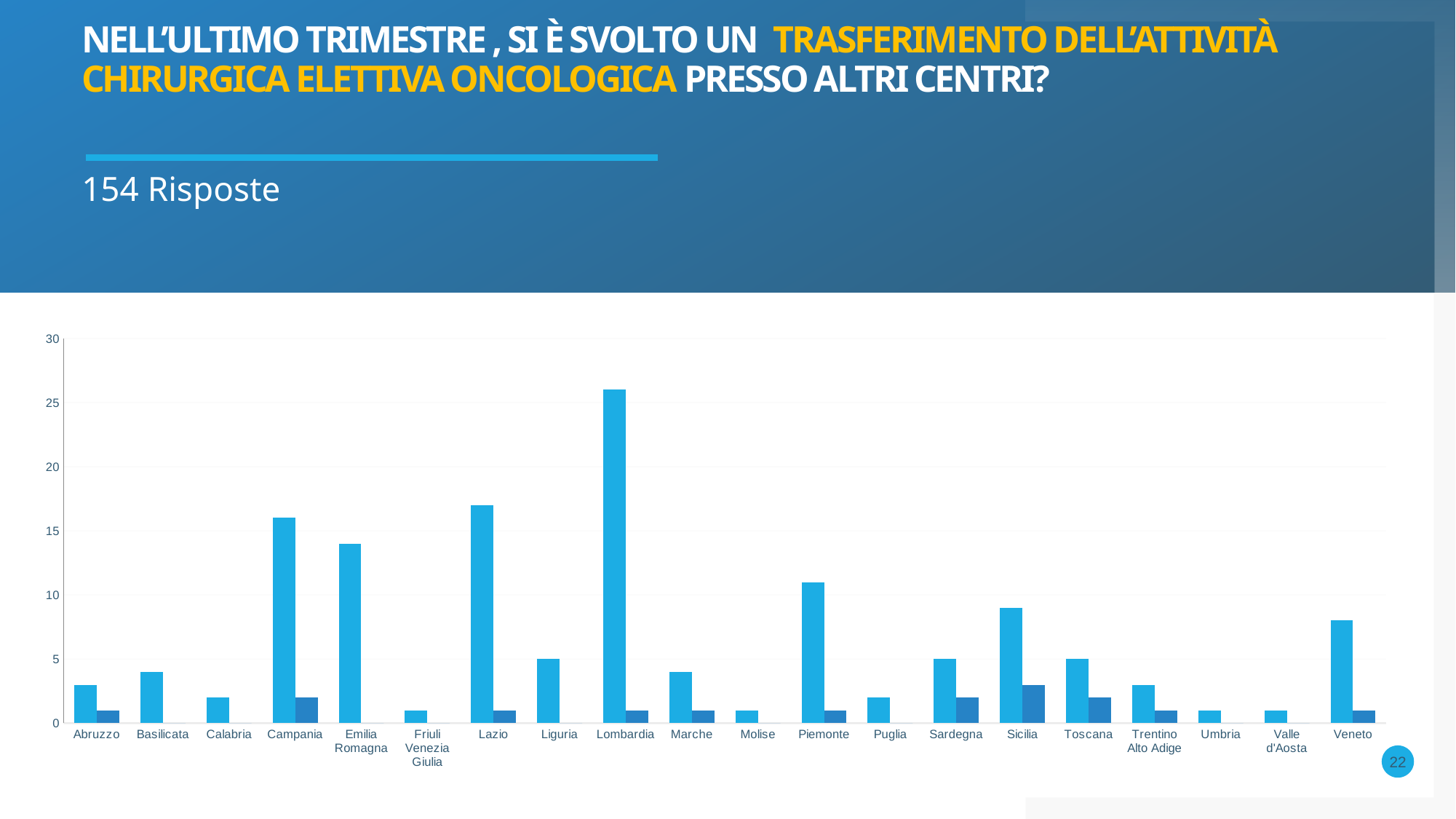
Is the light-blue value for Veneto greater or less than 10? less Is the light-blue value for Emilia Romagna greater or less than 15? less Which has the larger light-blue bar, Lombardia or Lazio? Lombardia How many regions are listed along the x axis? 20 Is the light-blue value for Lombardia greater or less than 25? greater How many responses does the slide say the chart is based on? 154 Risposte Which has the larger light-blue bar, Piemonte or Sicilia? Piemonte What kind of chart is shown on the slide? bar chart Which region has the highest light-blue bar? Lombardia What is the light-blue value for Liguria? 5